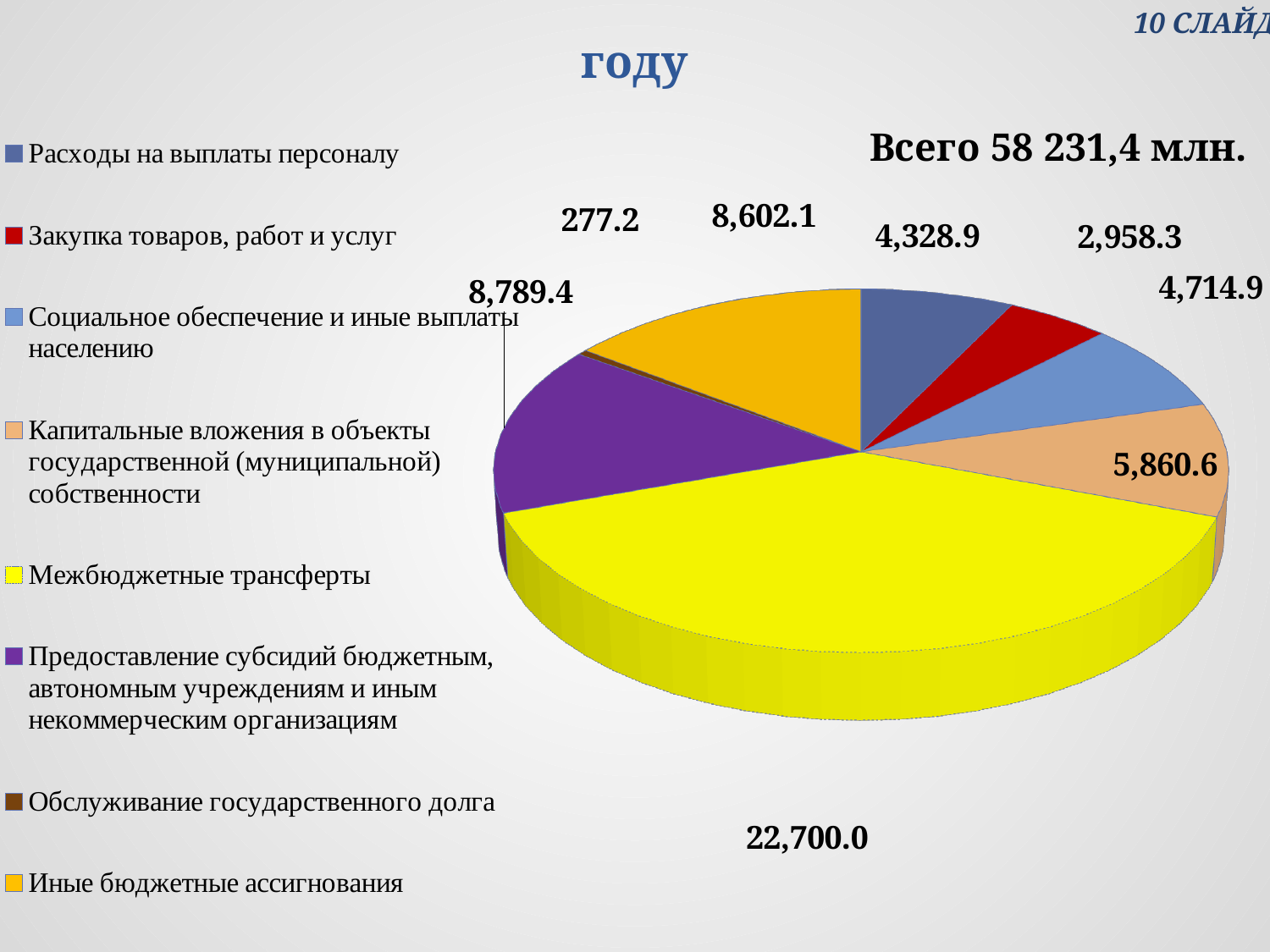
Which category has the smallest slice of the pie? Обслуживание государственного долга What is the difference between Предоставление субсидий бюджетным, автономным учреждениям и иным некоммерческим организациям and Иные бюджетные ассигнования? 187.3 What total is stated on the slide for all categories? 58 231,4 млн. What is the value for Обслуживание государственного долга? 277.2 Which category has the largest slice of the pie? Межбюджетные трансферты What is the value for Расходы на выплаты персоналу? 4,328.9 What is the value for Капитальные вложения в объекты государственной (муниципальной) собственности? 5,860.6 How many categories does the pie chart show? 8 What kind of chart is shown on the slide? Pie chart What colour is the slice for Межбюджетные трансферты? Yellow What is the value for Межбюджетные трансферты? 22,700.0 Which is larger: Социальное обеспечение и иные выплаты населению or Закупка товаров, работ и услуг? Социальное обеспечение и иные выплаты населению